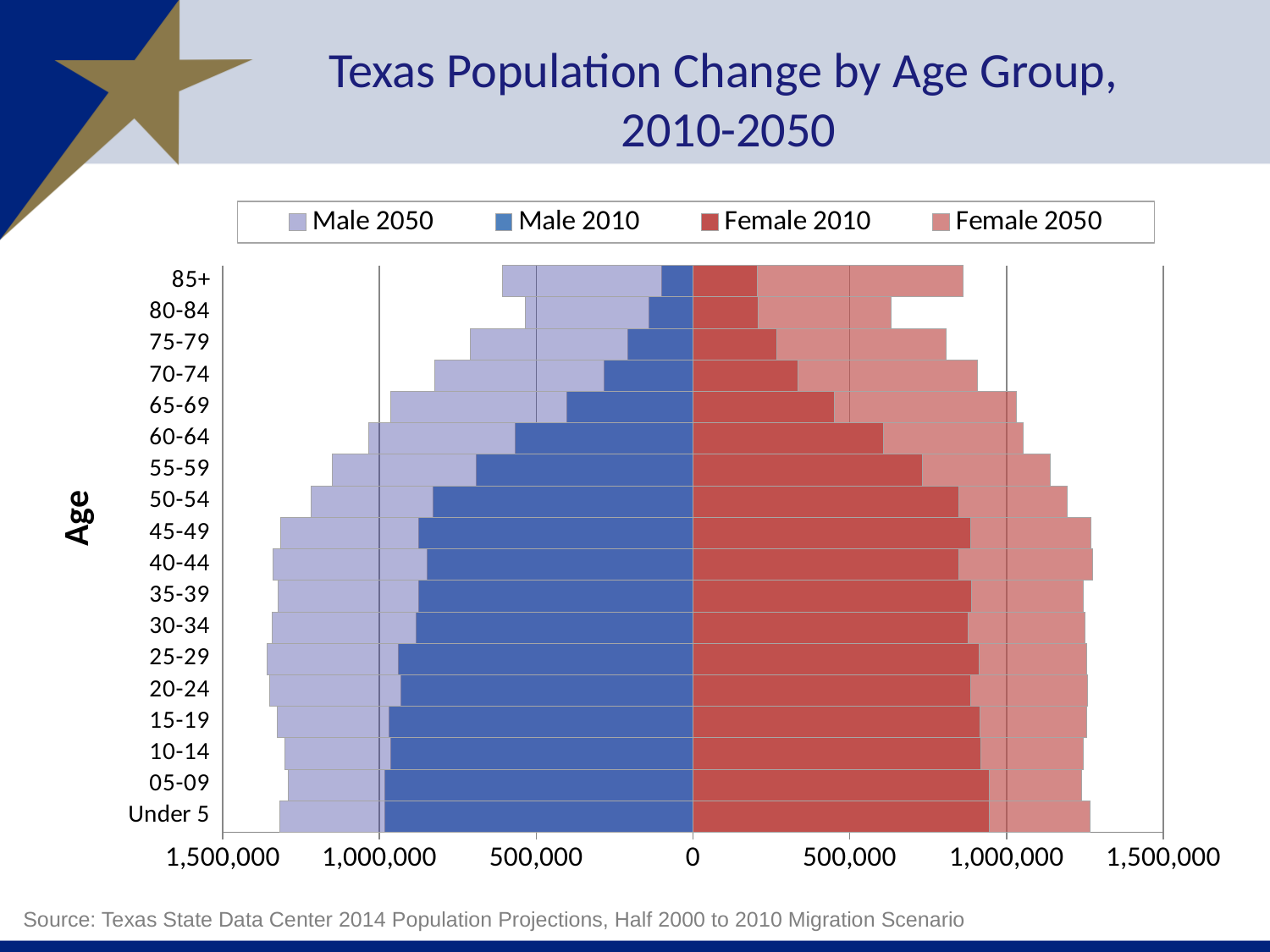
How many series does the legend list? 4 How many age groups are shown on the vertical axis? 18 What is the label on the vertical axis? Age Which age group has the lowest Male 2010 value? 85+ Is the Female 2050 value for the 85+ age group greater or less than 500,000? greater For the 85+ age group, which is larger: the Male 2050 value or the Male 2010 value? Male 2050 Is the Male 2050 value for the Under 5 age group greater or less than 1,000,000? greater Which series are listed in the legend? Male 2050, Male 2010, Female 2010, Female 2050 What kind of chart is shown on the slide? bar chart Is the Male 2010 value for the 85+ age group greater or less than 500,000? less Moving from the 50-54 age group up to the 85+ age group, do the Female 2010 values rise or fall? fall